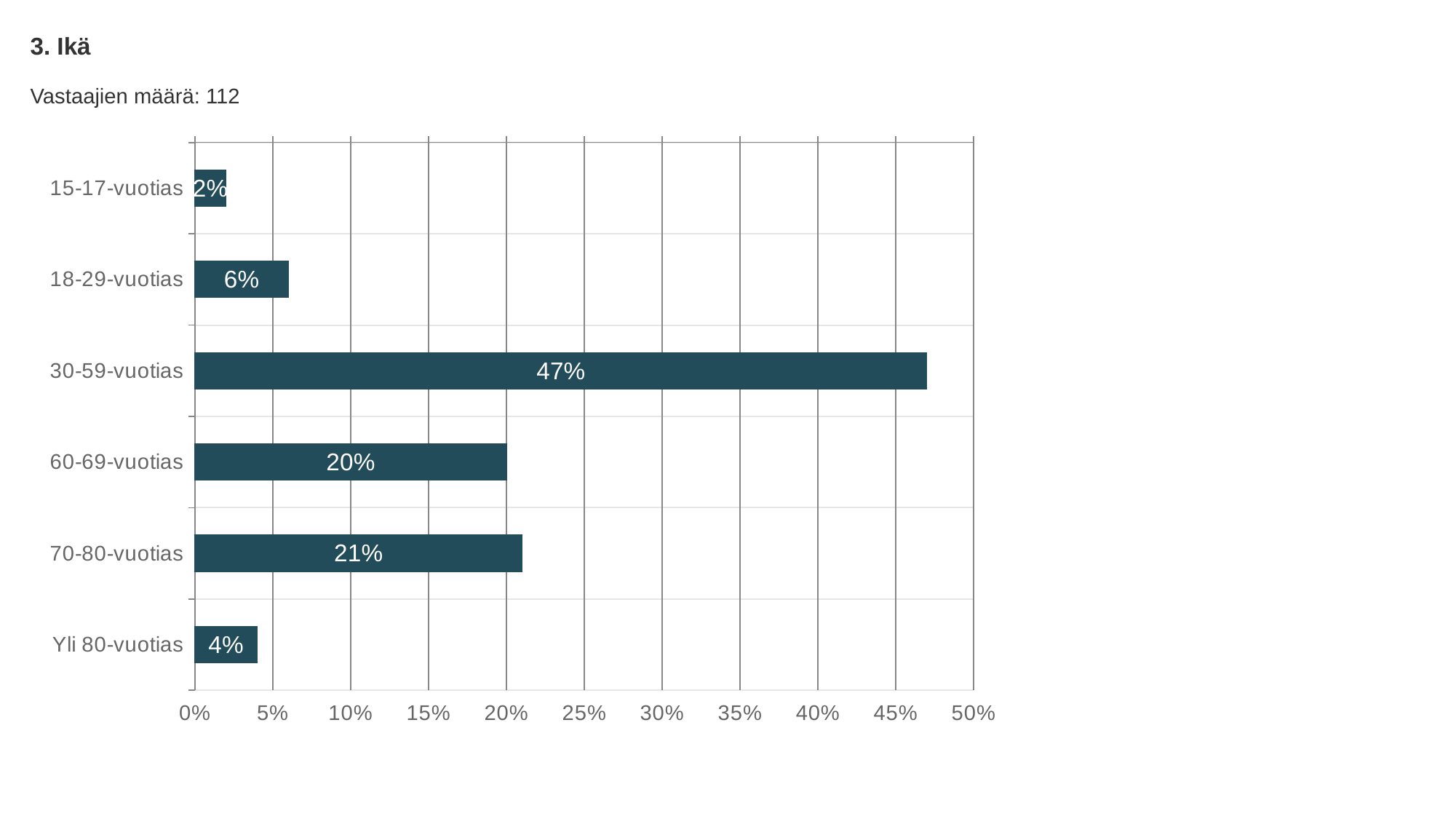
What is the title of the chart? 3. Ikä What is the difference between the values for 30-59-vuotias and 70-80-vuotias? 26% Is the value for 70-80-vuotias greater or less than 15%? greater What kind of chart is shown on the slide? bar chart How many respondents (Vastaajien määrä) are reported on the slide? 112 What is the value for Yli 80-vuotias? 4% Which age group has the lowest value? 15-17-vuotias How many age groups are shown in the chart? 6 What is the value for 60-69-vuotias? 20% Which is larger, the value for 18-29-vuotias or the value for Yli 80-vuotias? 18-29-vuotias What is the value for 30-59-vuotias? 47% Which age group has the highest value? 30-59-vuotias